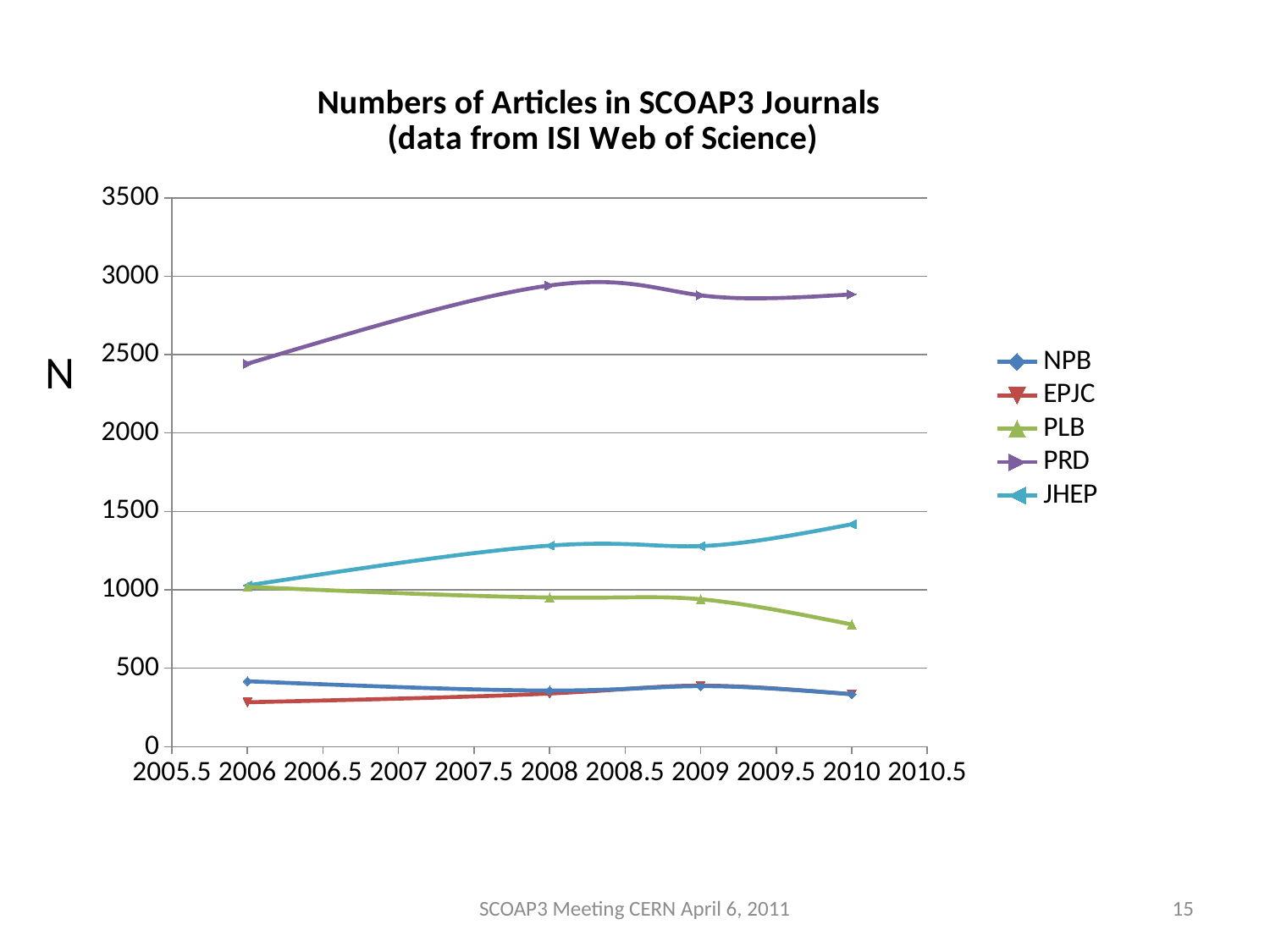
In 2010, which is larger, the value for JHEP or the value for PLB? JHEP Is the value for PRD in 2006 greater or less than 2500? less Is the value for PRD in 2008 greater or less than 2500? greater Does the PLB line rise or fall from 2006 to 2010? fall Which journal has the lowest number of articles in 2006? EPJC Is the value for PLB in 2010 greater or less than 1000? less Which journal has the highest number of articles in 2010? PRD How many series does the legend list? 5 Does the JHEP line rise or fall from 2006 to 2010? rise What is the label on the vertical axis of the chart? N What kind of chart is shown on the slide? line chart